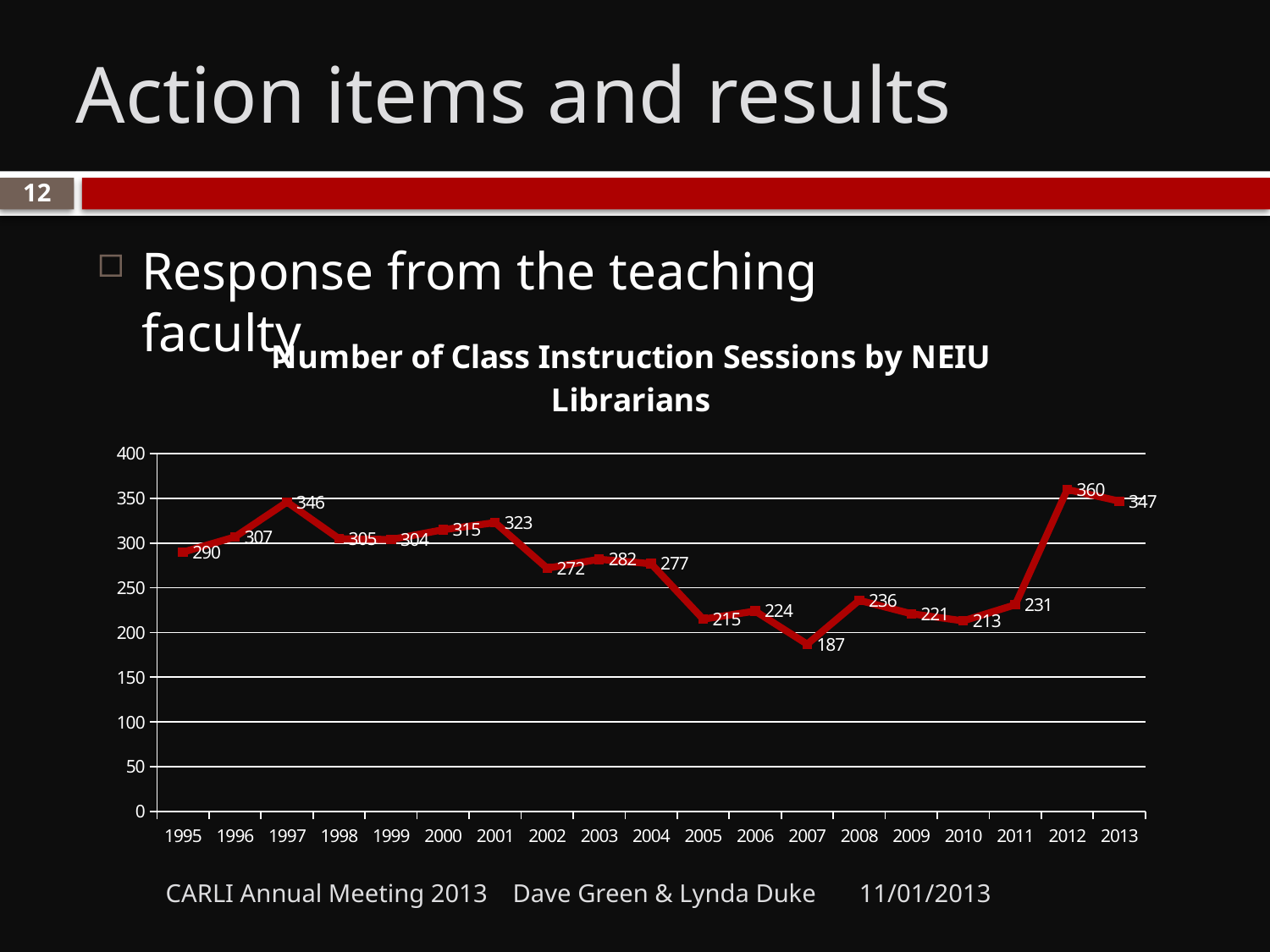
What is the number of class instruction sessions in 2007? 187 What is the title of the chart? Number of Class Instruction Sessions by NEIU Librarians Which year had more class instruction sessions, 2001 or 2003? 2001 Do the values rise or fall from 2001 to 2002? fall Which year has the highest number of class instruction sessions? 2012 Is the value for 2005 greater or less than 250? less What is the number of class instruction sessions in 1997? 346 How many years are plotted on the x axis of the chart? 19 What is the difference between the number of sessions in 2012 and in 2011? 129 What type of chart is shown on the slide? line chart Which year has the lowest number of class instruction sessions? 2007 What is the number of class instruction sessions in 2013? 347